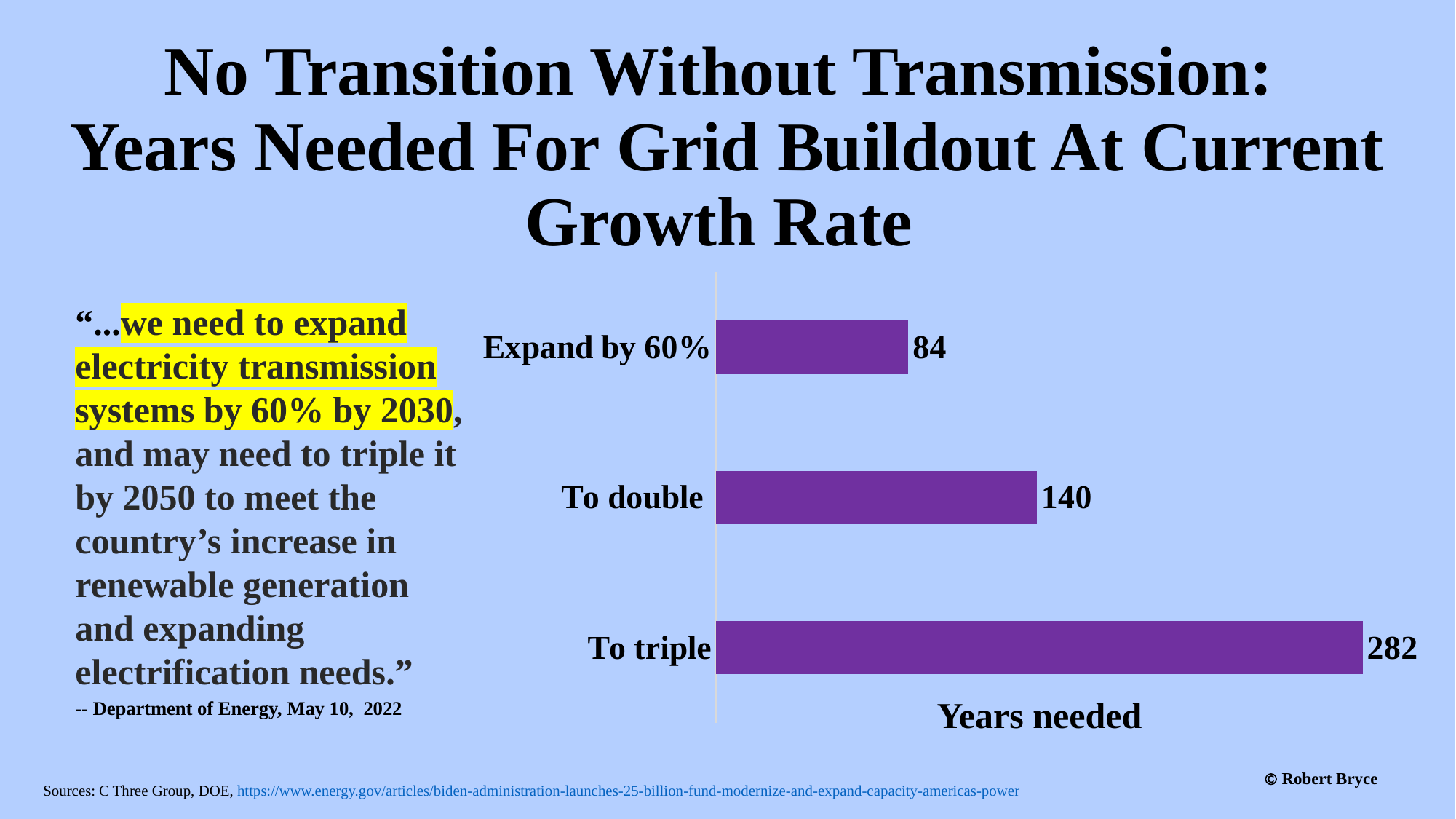
Which category requires the fewest years? Expand by 60% What colour are the bars in the chart? Purple How many years are needed to expand the grid by 60%? 84 How many years are needed to double the grid? 140 Which requires more years: expanding by 60% or doubling? To double How many more years are needed to triple the grid than to double it? 142 How many years are needed to triple the grid? 282 What kind of chart is shown on the slide? Bar chart What is the label on the horizontal axis of the chart? Years needed How many categories are shown in the chart? 3 Which category requires the most years? To triple What is the difference in years needed between doubling the grid and expanding it by 60%? 56